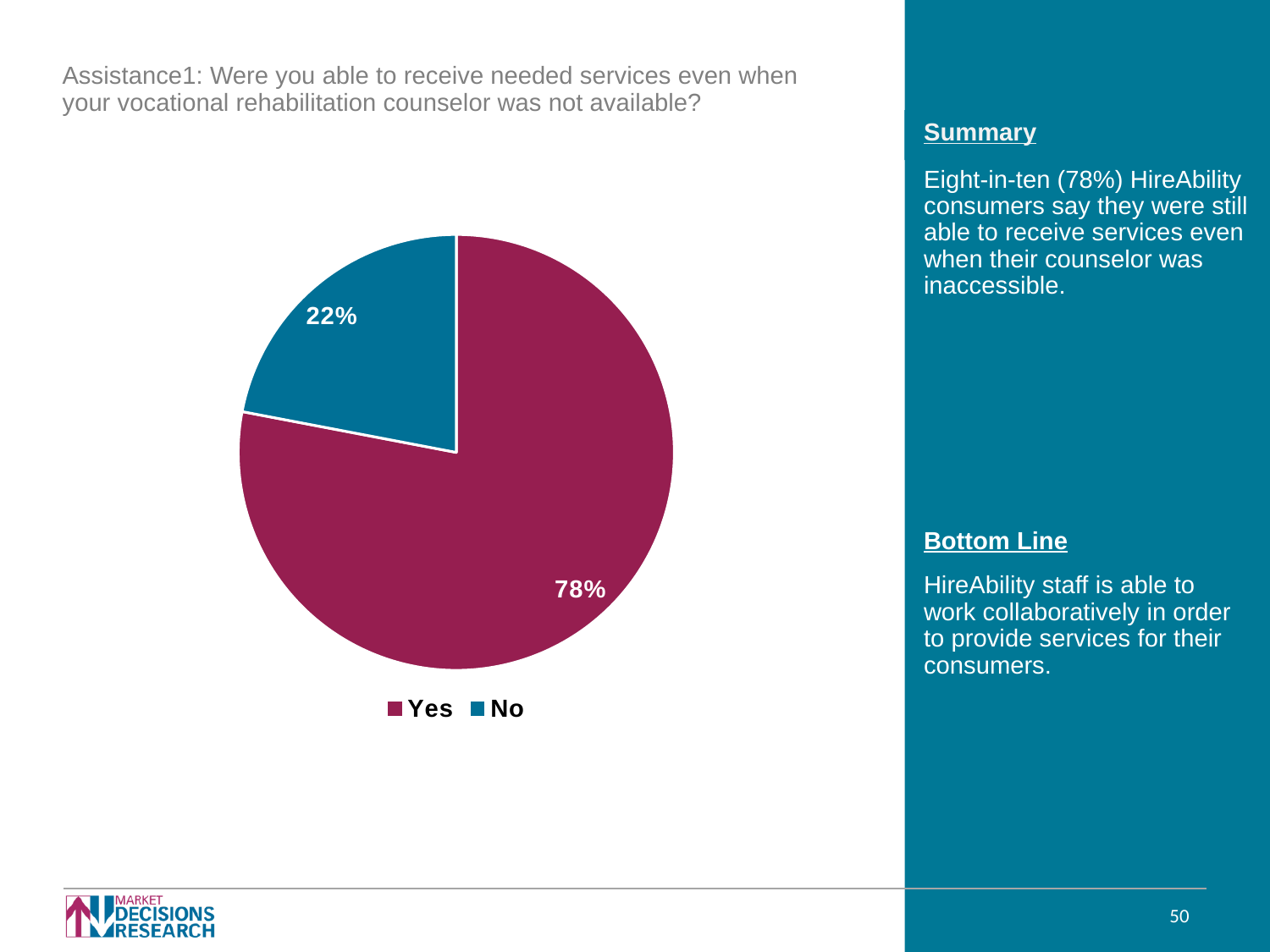
What kind of chart is shown on the slide? Pie chart How many entries does the legend list? 2 What share of the pie does the "No" slice represent? 22% What percentage of respondents answered "Yes"? 78% Which is larger, the "Yes" slice or the "No" slice? Yes What is the difference in percentage points between the "Yes" and "No" slices? 56 Which response has the largest share of the pie? Yes What colour is the "Yes" slice? Maroon Which response has the smallest share of the pie? No What colour is the "No" slice? Blue What percentage of respondents answered "No"? 22% How many slices does the pie chart have? 2